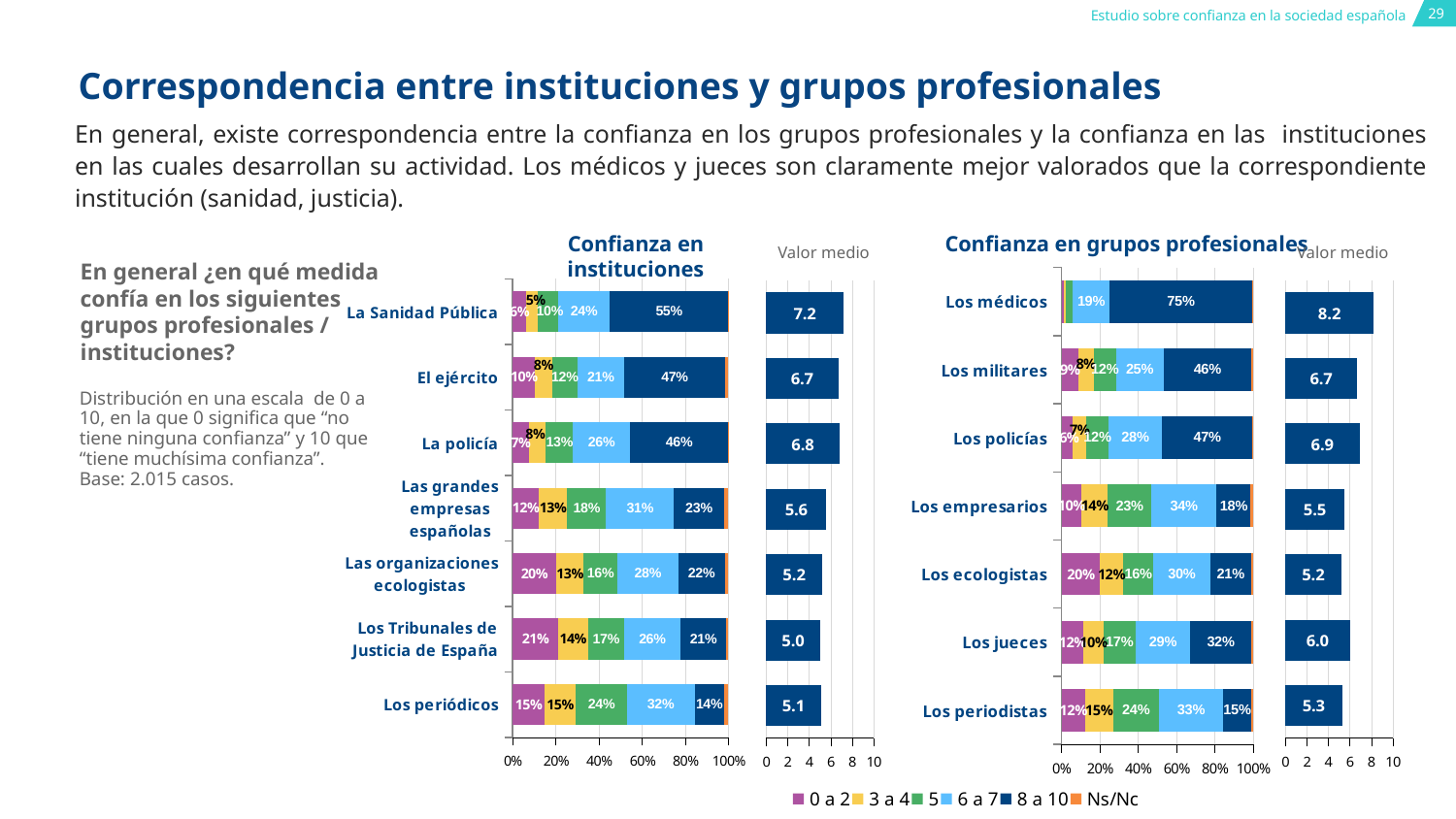
What is the difference between the mean value for Los médicos (8.2) and the mean value for La Sanidad Pública (7.2)? 1.0 In the 'Confianza en grupos profesionales' chart, what percentage of respondents gave Los jueces a score of 6 a 7? 29% In the 'Confianza en grupos profesionales' chart, what percentage of respondents gave Los médicos a score of 8 a 10? 75% In the 'Confianza en instituciones' chart, what percentage of respondents gave La Sanidad Pública a score of 8 a 10? 55% How many categories are shown in the 'Confianza en grupos profesionales' chart? 7 How many series does the legend at the bottom of the slide list? 6 In the 'Valor medio' bars next to the 'Confianza en grupos profesionales' chart, which group has the highest mean value? Los médicos In the 'Valor medio' bars next to the 'Confianza en grupos profesionales' chart, is the mean value for Los periodistas greater or less than 6? less In the 'Confianza en instituciones' chart, which has a larger share of 0 a 2 scores: Los Tribunales de Justicia de España or Los periódicos? Los Tribunales de Justicia de España What kind of chart is the 'Confianza en instituciones' chart? Stacked bar chart In the 'Valor medio' bars next to the 'Confianza en instituciones' chart, what is the mean value for Los Tribunales de Justicia de España? 5.0 In the 'Valor medio' bars next to the 'Confianza en instituciones' chart, which institution has the lowest mean value? Los Tribunales de Justicia de España